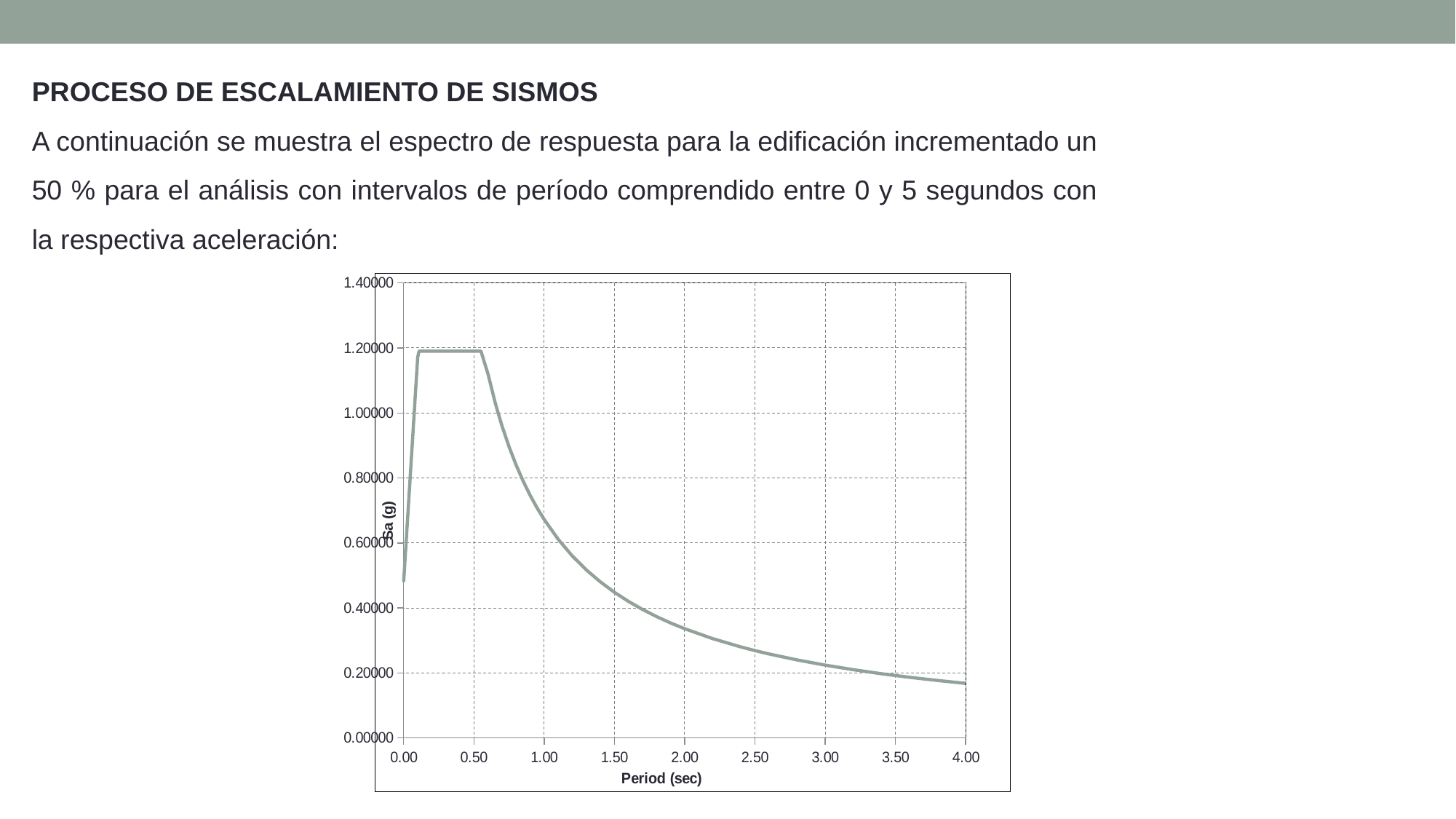
Is the value of Sa (g) larger at a period of 0.00 sec or at a period of 0.50 sec? 0.50 sec Is the value of Sa (g) at a period of 2.00 sec greater or less than 0.40? less What is the label of the x axis of the chart? Period (sec) What kind of chart is shown on the slide? line chart Is the value of Sa (g) at a period of 1.00 sec greater or less than 0.80? less Is the value of Sa (g) at a period of 4.00 sec greater or less than 0.20? less Do the values of Sa (g) rise or fall as the period increases from 1.00 sec to 4.00 sec? fall Is the value of Sa (g) larger at a period of 1.00 sec or at a period of 3.00 sec? 1.00 sec What is the label of the y axis of the chart? Sa (g)